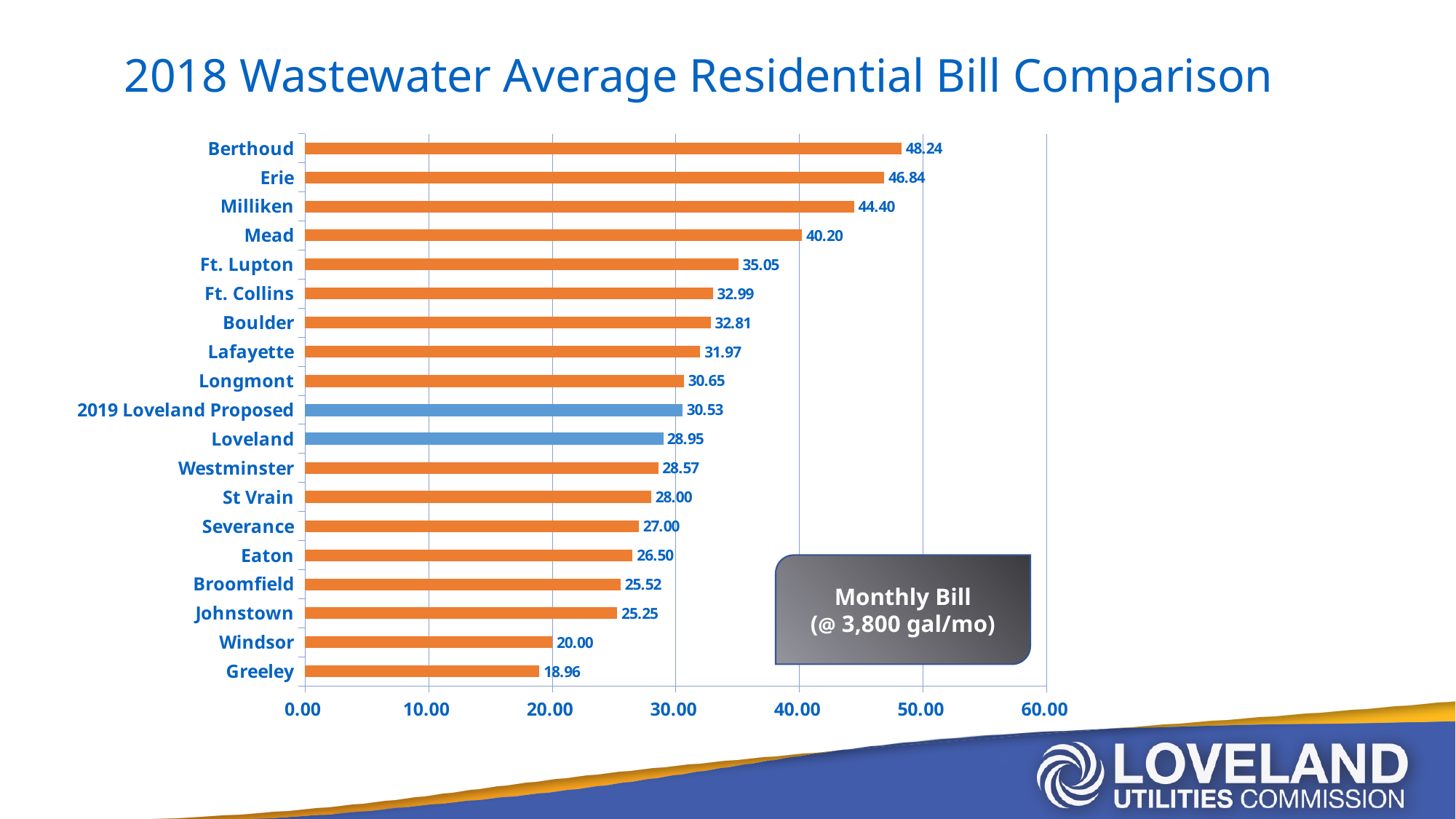
What is the value for Berthoud? 48.24 Is the value for Erie greater or less than 40.00? greater Which two categories are shown with blue bars instead of orange? 2019 Loveland Proposed and Loveland Which category has the lowest value? Greeley What is the title of the chart? 2018 Wastewater Average Residential Bill Comparison What is the difference between the values for 2019 Loveland Proposed and Loveland? 1.58 Which is larger, the value for Mead or the value for Ft. Lupton? Mead What is the value for Greeley? 18.96 What is the value for 2019 Loveland Proposed? 30.53 How many categories are shown in the chart? 19 Which category has the highest value? Berthoud What kind of chart is shown on the slide? bar chart